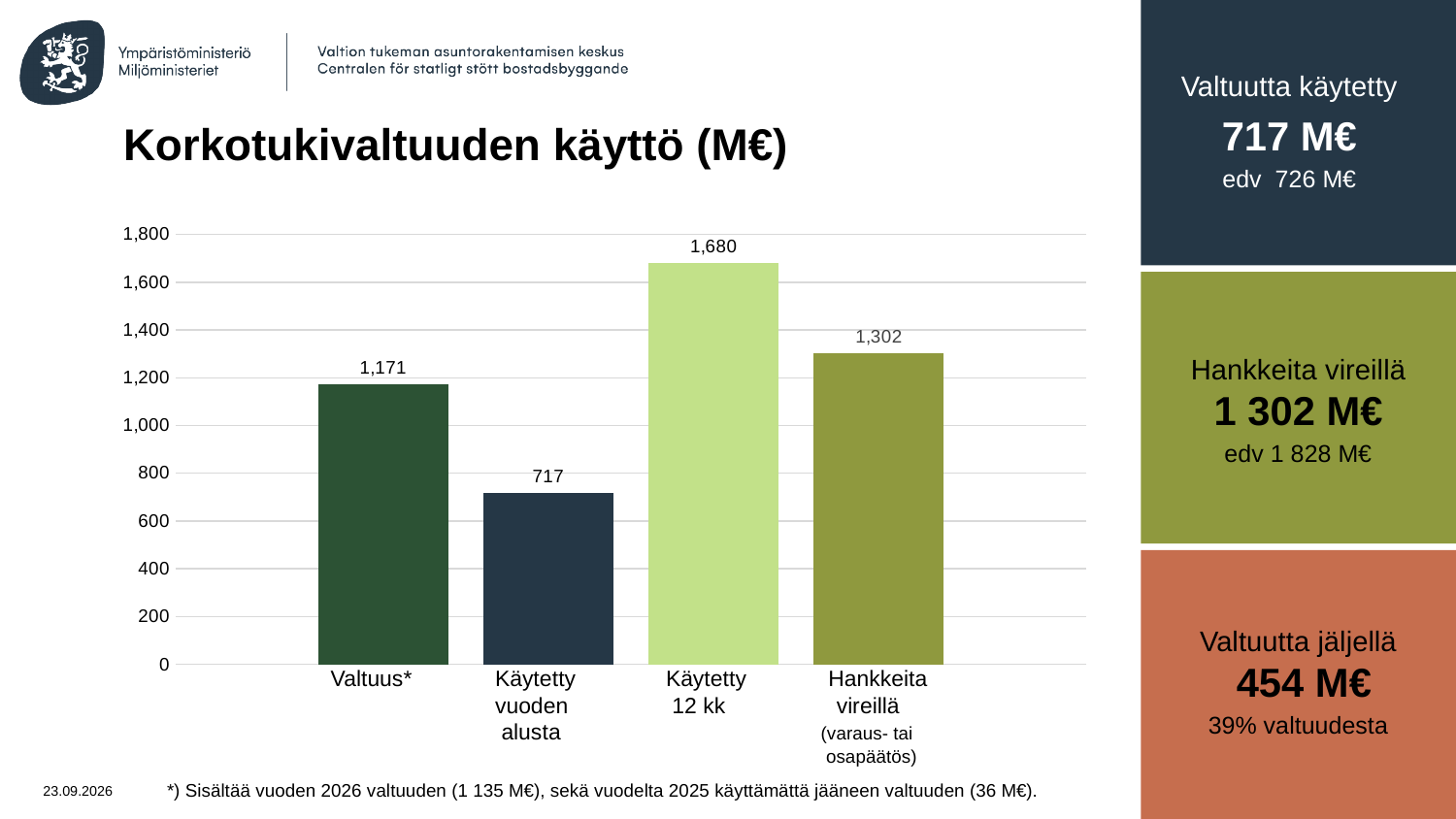
What is the difference between Valtuus* and Käytetty vuoden alusta? 454 What is the value for Käytetty 12 kk? 1,680 Which category has the lowest value? Käytetty vuoden alusta What is the title of the chart? Korkotukivaltuuden käyttö (M€) How many bars are shown in the chart? 4 What is the difference between Käytetty 12 kk and Hankkeita vireillä? 378 What is the value for Käytetty vuoden alusta? 717 What is the value of the Valtuus* bar? 1,171 What is the value for Hankkeita vireillä? 1,302 What type of chart is shown? Bar chart Which is larger, Valtuus* or Hankkeita vireillä? Hankkeita vireillä Which category has the highest value? Käytetty 12 kk